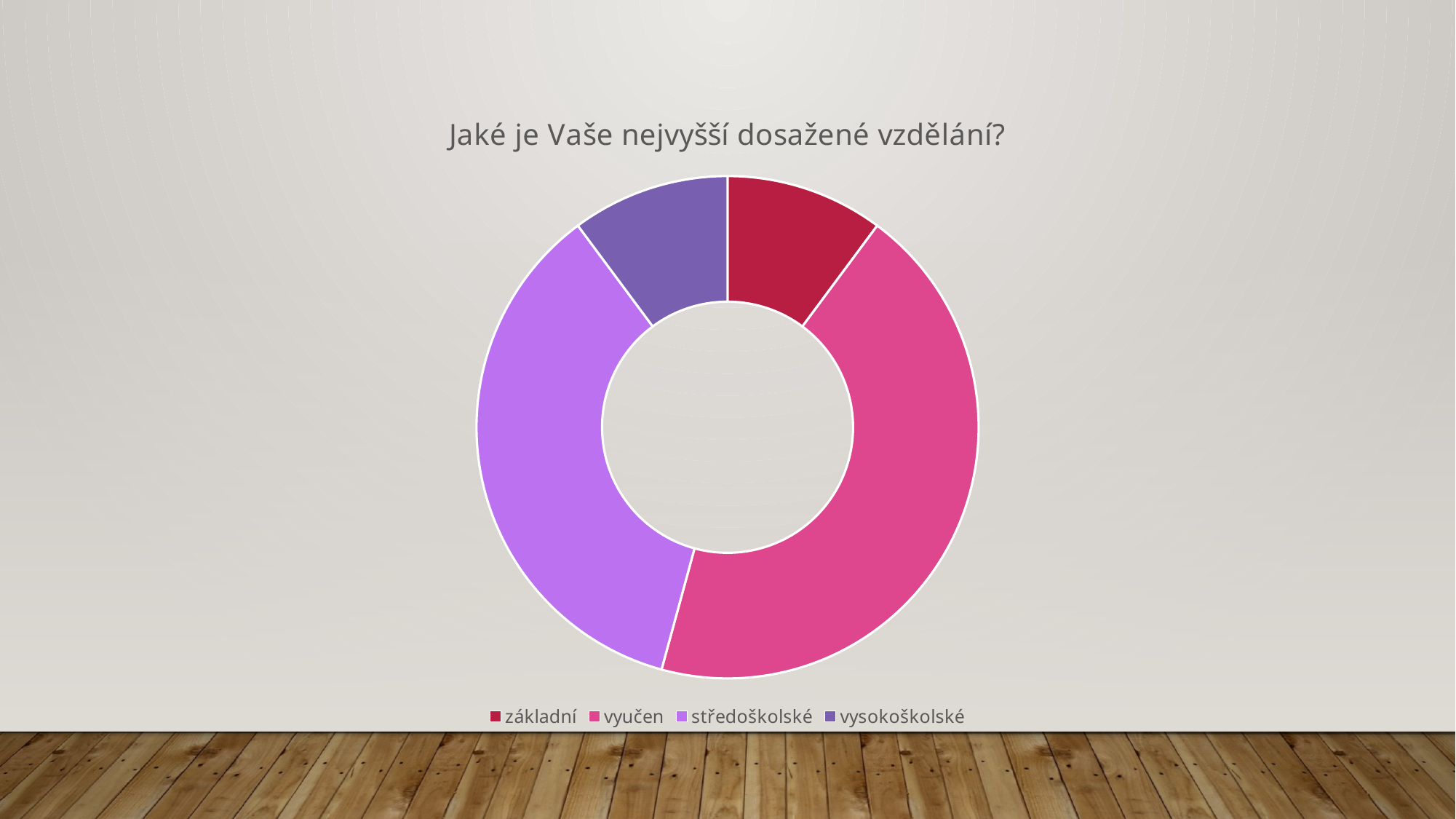
Which category is shown in the light purple colour? středoškolské What kind of chart is shown on the slide? doughnut chart Which is larger, the share for vyučen or the share for základní? vyučen Which category has the largest share of the chart? vyučen Which is larger, the share for středoškolské or the share for vysokoškolské? středoškolské How many entries does the legend list? 4 What is the title of the chart? Jaké je Vaše nejvyšší dosažené vzdělání? Which is larger, the share for vyučen or the share for středoškolské? vyučen How many categories does the chart show? 4